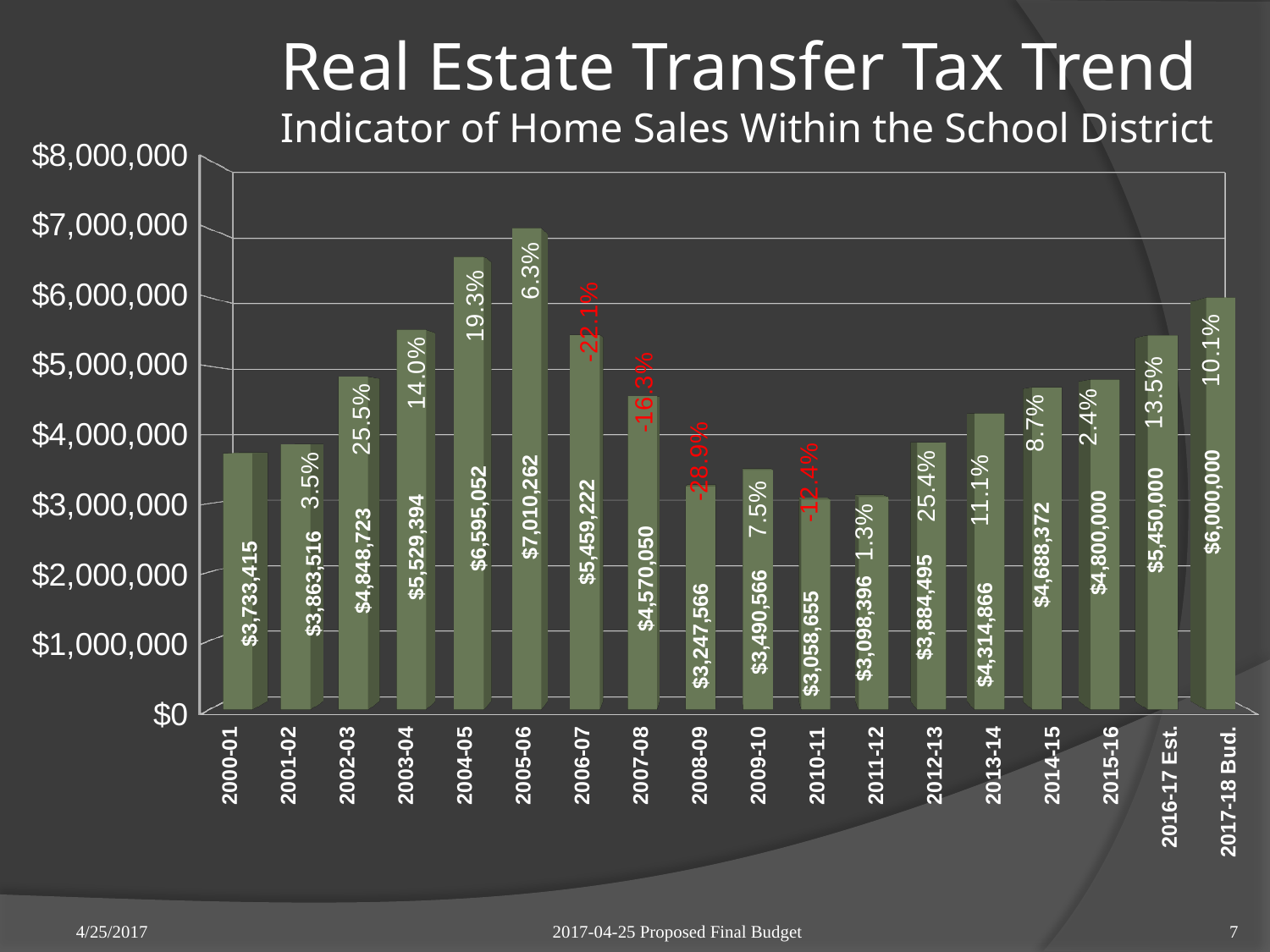
Which is larger, the value for 2003-04 or the value for 2006-07? 2003-04 Is the value for 2004-05 greater or less than $6,000,000? greater Do the values rise or fall from 2005-06 to 2008-09? fall What kind of chart is shown on the slide? bar chart How many years (categories) are shown on the x axis? 18 What is the difference between the 2015-16 value and the 2014-15 value? $111,628 What is the difference between the 2017-18 Bud. value and the 2016-17 Est. value? $550,000 Which year has the highest real estate transfer tax value? 2005-06 What is the real estate transfer tax value for 2005-06? $7,010,262 Which year has the lowest real estate transfer tax value? 2010-11 What percentage change is shown above the 2008-09 bar? -28.9% What is the value shown for 2017-18 Bud.? $6,000,000